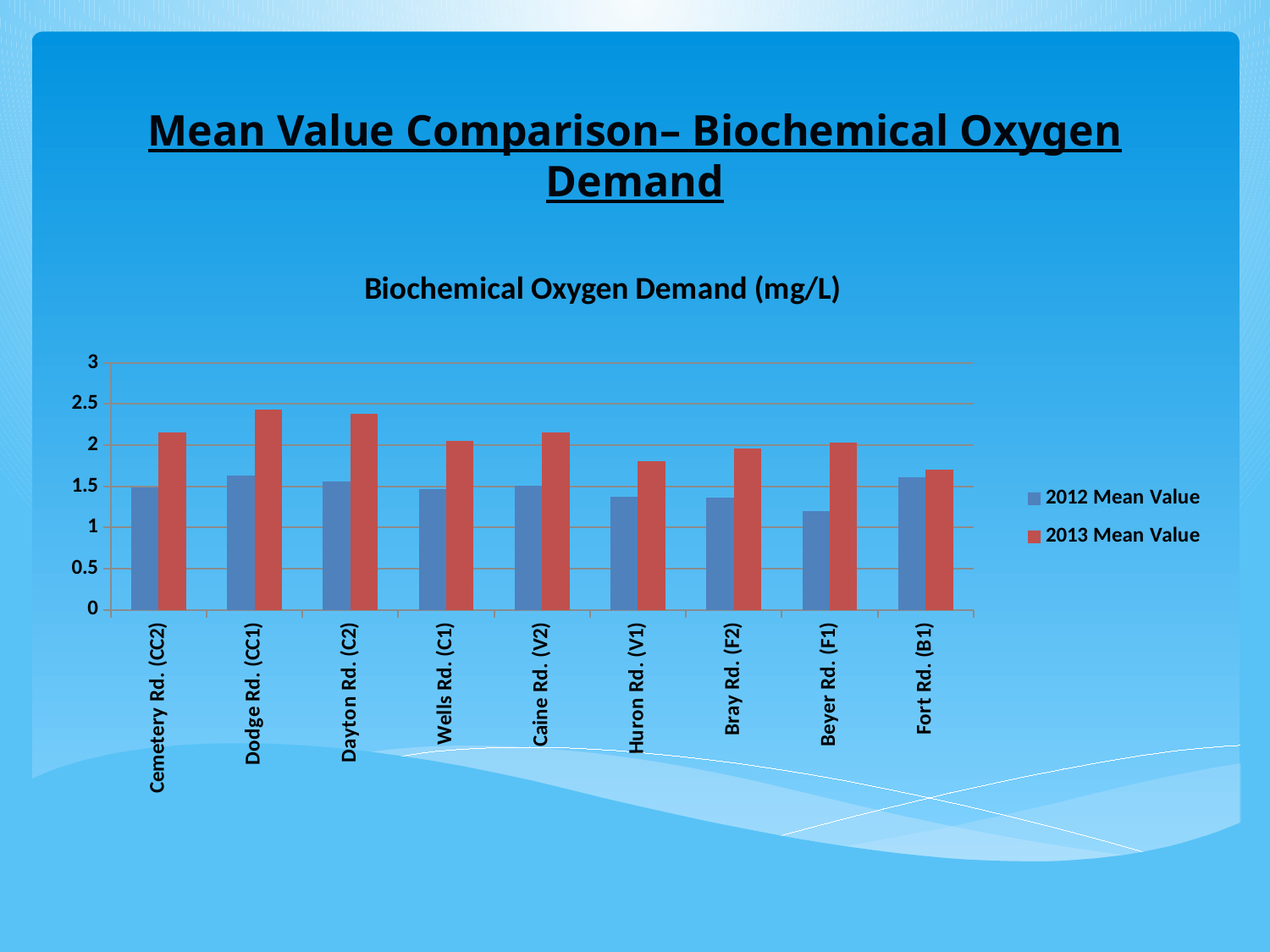
Is the 2013 Mean Value for Fort Rd. (B1) greater or less than 2? less How many series does the chart legend list? 2 Is the 2013 Mean Value for Huron Rd. (V1) greater or less than 2? less Which site has the lowest 2012 Mean Value? Beyer Rd. (F1) Is the 2013 Mean Value for Dodge Rd. (CC1) greater or less than 2? greater What is the title of the chart? Biochemical Oxygen Demand (mg/L) Which is larger: the 2013 Mean Value for Dodge Rd. (CC1) or for Huron Rd. (V1)? Dodge Rd. (CC1) How many sites (categories) are shown on the x axis of the chart? 9 What kind of chart is shown on the slide? bar chart Which series is shown in red in the chart? 2013 Mean Value At Cemetery Rd. (CC2), which is larger: the 2012 Mean Value or the 2013 Mean Value? 2013 Mean Value